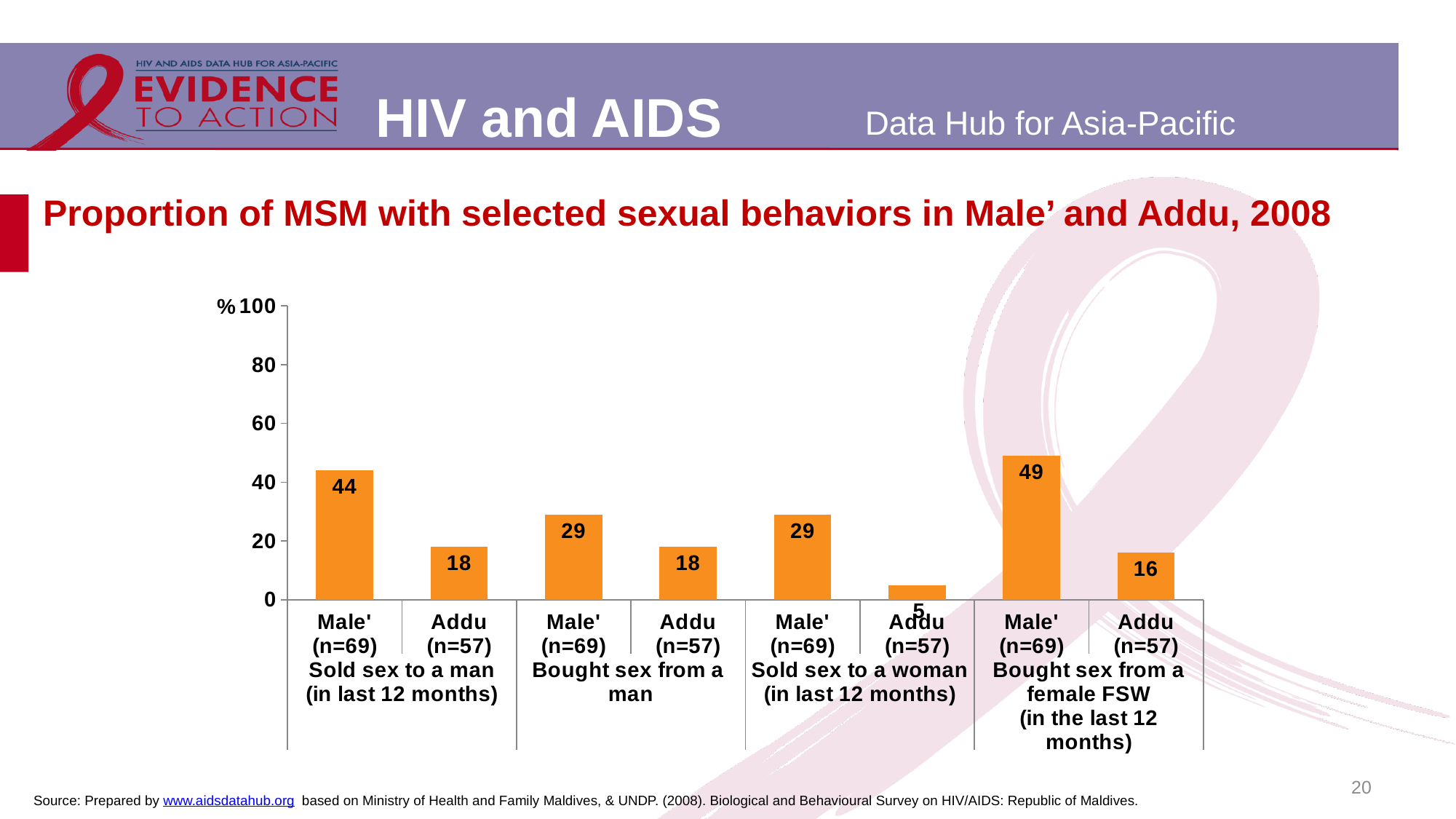
Which bar has the lowest value on the chart? Addu (n=57), Sold sex to a woman (in last 12 months) Which is larger: Male' for 'Bought sex from a man' or Male' for 'Sold sex to a man (in last 12 months)'? Male' for 'Sold sex to a man (in last 12 months)' Is the value for Male' (n=69) for 'Bought sex from a female FSW' greater or less than 40? greater What is the difference between Male' and Addu for 'Bought sex from a female FSW (in the last 12 months)'? 33 What type of chart is shown on the slide? Bar chart How many bars are plotted on the chart? 8 What is the value for Addu (n=57) for 'Bought sex from a female FSW (in the last 12 months)'? 16 What is the value for Addu (n=57) for 'Sold sex to a woman (in last 12 months)'? 5 What is the difference between Male' and Addu for 'Sold sex to a man (in last 12 months)'? 26 What is the title of the chart? Proportion of MSM with selected sexual behaviors in Male' and Addu, 2008 Which bar has the highest value on the chart? Male' (n=69), Bought sex from a female FSW (in the last 12 months) What is the value for Male' (n=69) for 'Sold sex to a man (in last 12 months)'? 44